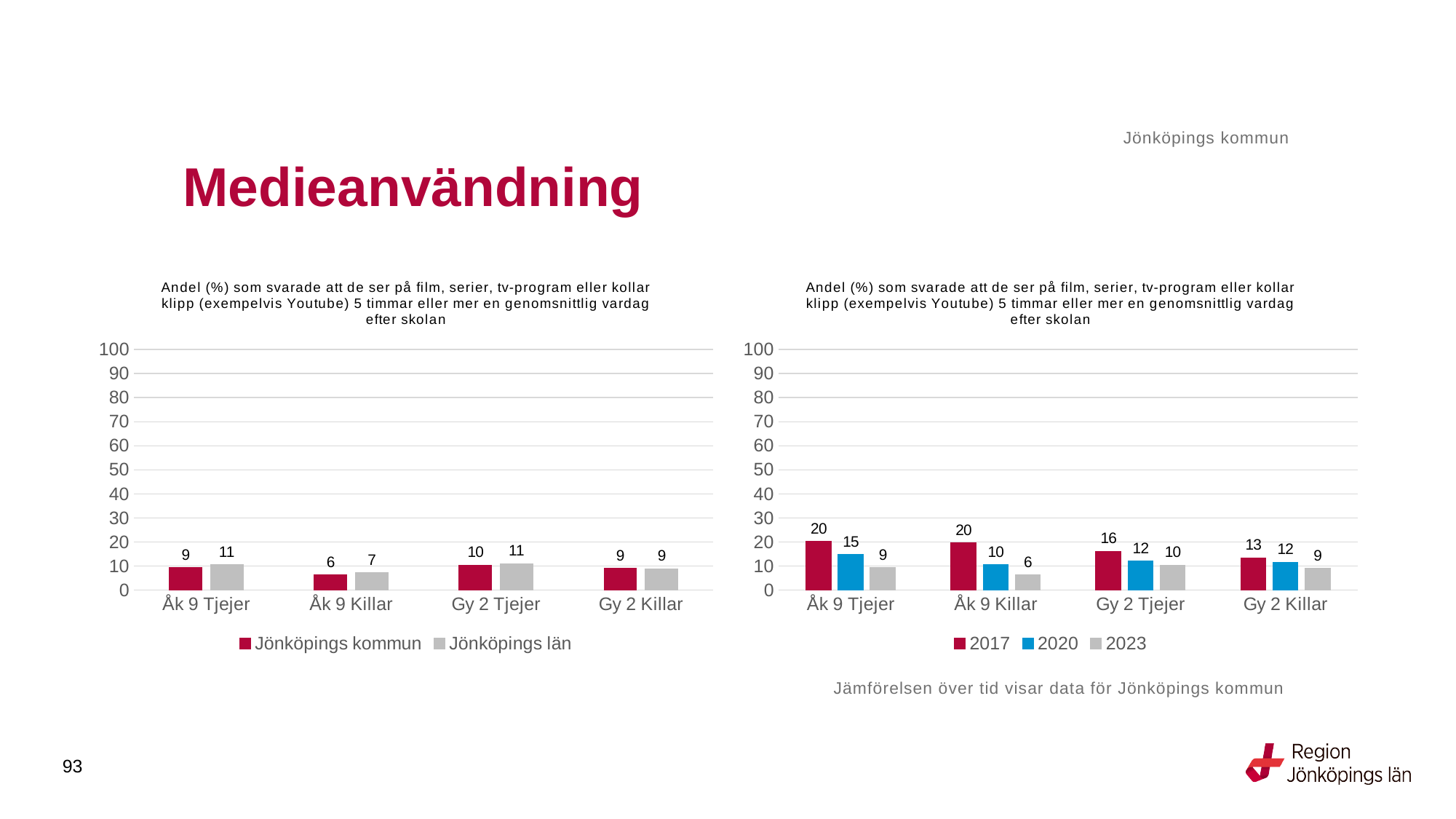
In the left chart, which category has the lowest value for Jönköpings kommun? Åk 9 Killar In the right chart, do the values for Gy 2 Tjejer rise or fall from 2017 to 2023? fall In the right chart, which category has the highest value for 2017? Åk 9 Tjejer and Åk 9 Killar (both 20) What kind of chart is the right chart? bar chart In the right chart, which is larger for Gy 2 Killar: the 2017 value or the 2023 value? 2017 In the right chart, what is the difference between 2017 and 2023 for Åk 9 Killar? 14 In the left chart, what is the difference between Jönköpings län and Jönköpings kommun for Åk 9 Tjejer? 2 In the right chart, what is the value for 2020 for Åk 9 Tjejer? 15 In the right chart, what is the value for 2023 for Åk 9 Killar? 6 In the left chart, what is the value for Jönköpings kommun for Åk 9 Killar? 6 In the left chart, what is the value for Jönköpings län for Gy 2 Tjejer? 11 In the left chart, how many series does the legend list? 2